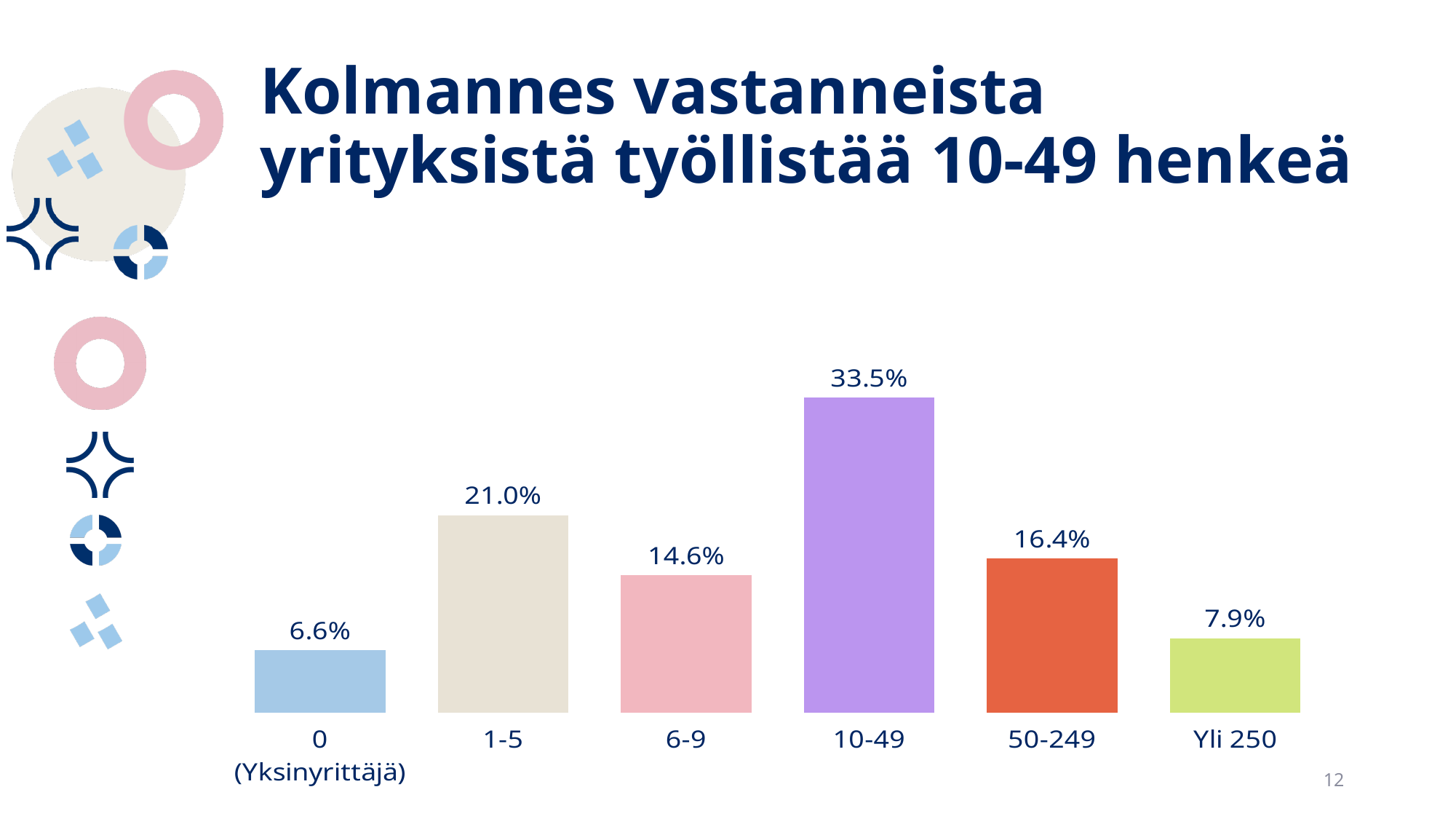
What kind of chart is shown on the slide? Bar chart Which category has the lowest value? 0 (Yksinyrittäjä) How many categories are shown in the chart? 6 What is the value for the 10-49 category? 33.5% What is the value for the Yli 250 category? 7.9% What is the value for the 0 (Yksinyrittäjä) category? 6.6% What is the difference between the values for 10-49 and 50-249? 17.1% Which is larger, the value for 1-5 or the value for 50-249? 1-5 What is the difference between the values for 1-5 and 6-9? 6.4% Which category has the highest value? 10-49 What is the title of the slide? Kolmannes vastanneista yrityksistä työllistää 10-49 henkeä What is the value for the 50-249 category? 16.4%